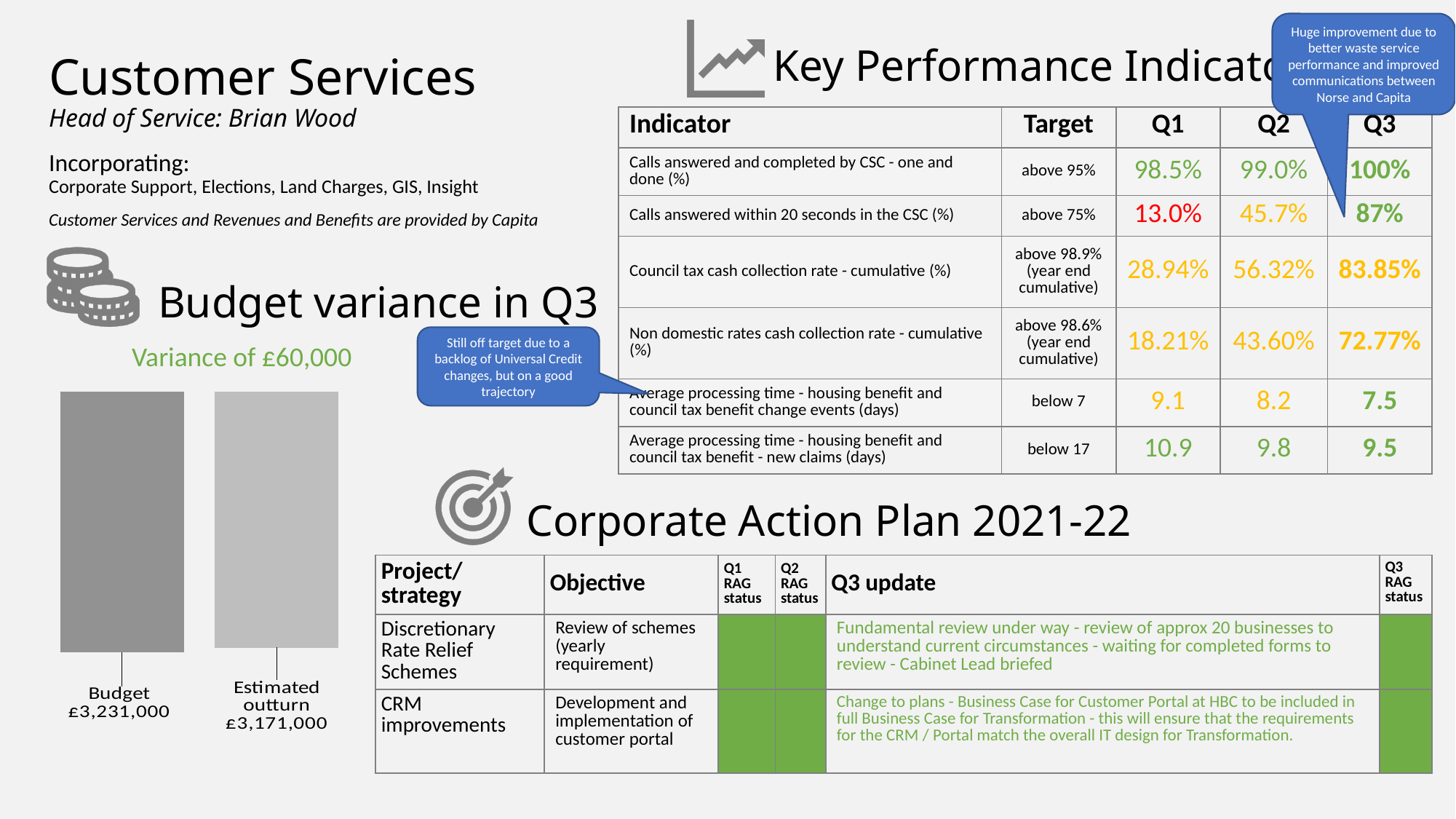
In the Budget variance in Q3 chart, what is the difference between the Budget and the Estimated outturn? £60,000 In the Budget variance in Q3 chart, do the values rise or fall from the Budget bar to the Estimated outturn bar? Fall In the Budget variance in Q3 chart, which category has the lowest value? Estimated outturn What is the title of the bar chart on the slide? Budget variance in Q3 In the Budget variance in Q3 chart, which bar is larger, Budget or Estimated outturn? Budget What variance amount is stated above the Budget variance in Q3 chart? Variance of £60,000 In the Budget variance in Q3 chart, what is the value of the Estimated outturn bar? £3,171,000 In the Budget variance in Q3 chart, what is the value of the Budget bar? £3,231,000 How many bars are shown in the Budget variance in Q3 chart? 2 What type of chart is used to show the Budget variance in Q3? Bar chart In the Budget variance in Q3 chart, which category has the highest value? Budget